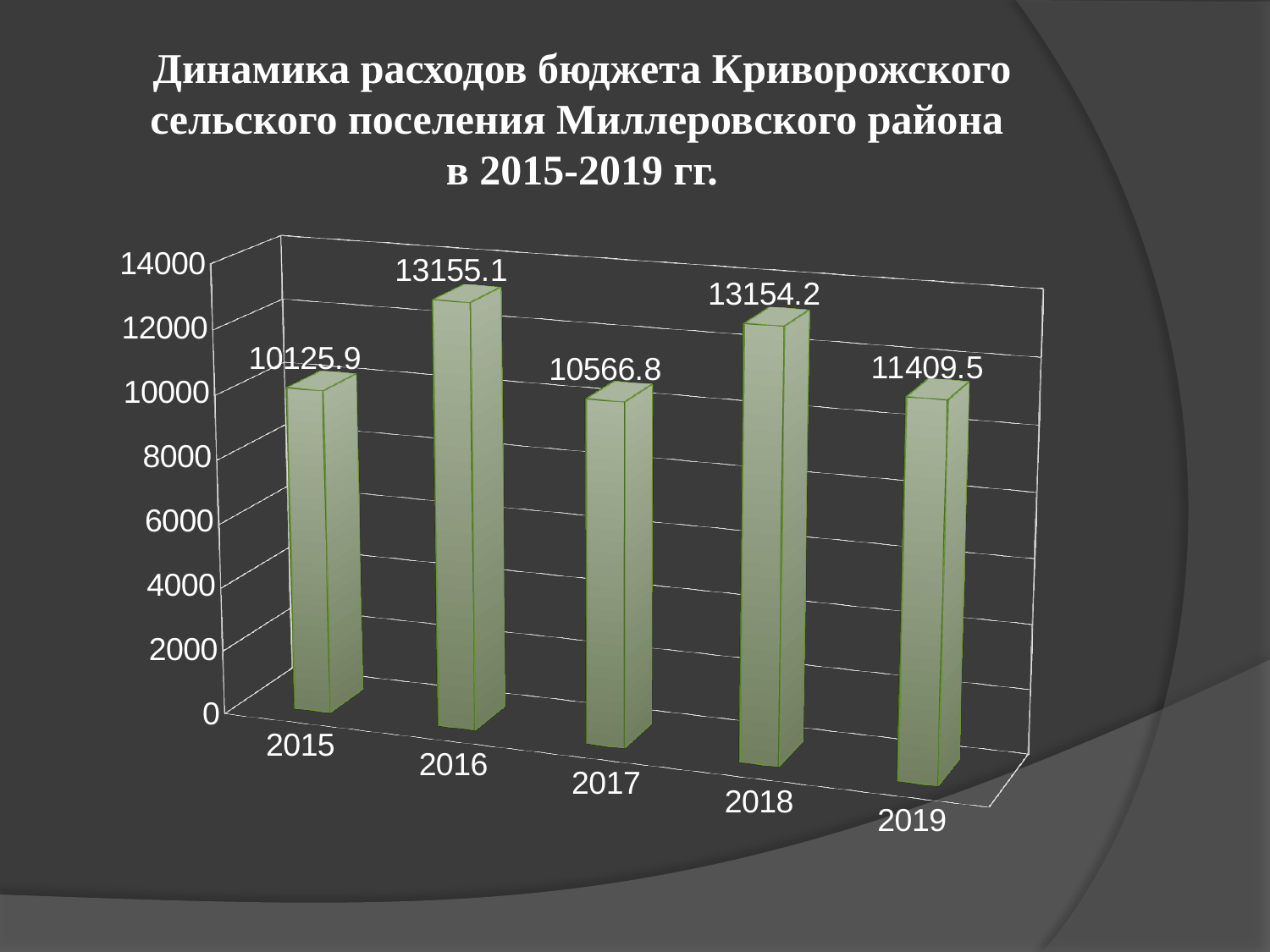
What is the value for 2019? 11409.5 What is the value for 2018? 13154.2 Which year has the lowest value? 2015 What kind of chart is shown on the slide? bar chart What is the value for 2015? 10125.9 What is the difference between the values for 2019 and 2017? 842.7 What is the difference between the values for 2016 and 2015? 3029.2 Which is larger, the value for 2017 or the value for 2019? 2019 Is the value for 2019 greater or less than 10000? greater What is the value for 2016? 13155.1 What is the value for 2017? 10566.8 How many years are shown on the chart? 5